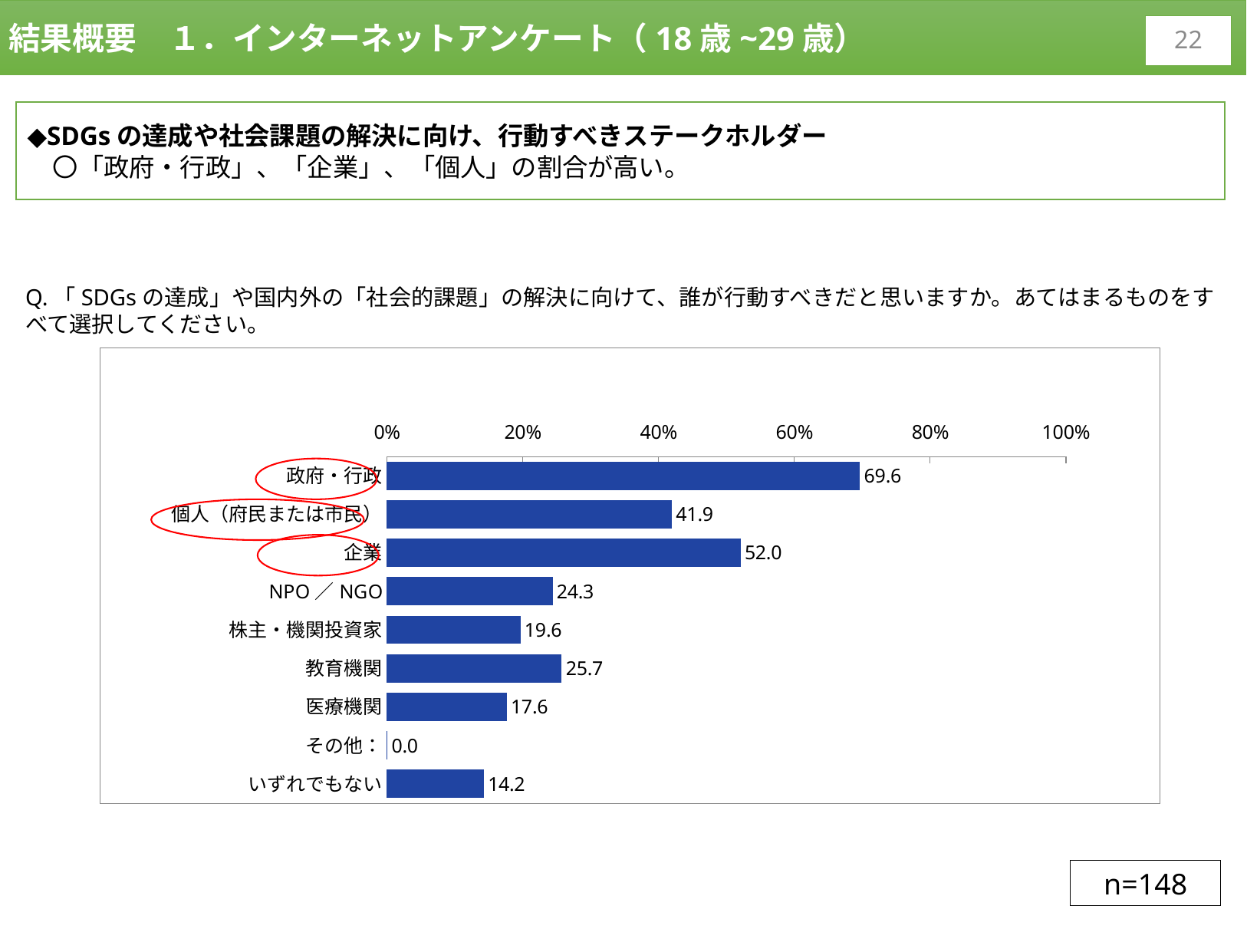
What is the value for 株主・機関投資家? 19.6 What kind of chart is shown on the slide? bar chart What is the value for 企業? 52.0 Which category has the lowest value? その他： What is the value for いずれでもない? 14.2 Which category has the highest value? 政府・行政 What is the difference between the values for 政府・行政 and 企業? 17.6 Is the value for 個人（府民または市民） greater or less than 40%? greater Which is larger, the value for 教育機関 or the value for NPO／NGO? 教育機関 How many categories are shown in the chart? 9 What is the value for 政府・行政? 69.6 What is the sample size (n) shown on the slide? n=148